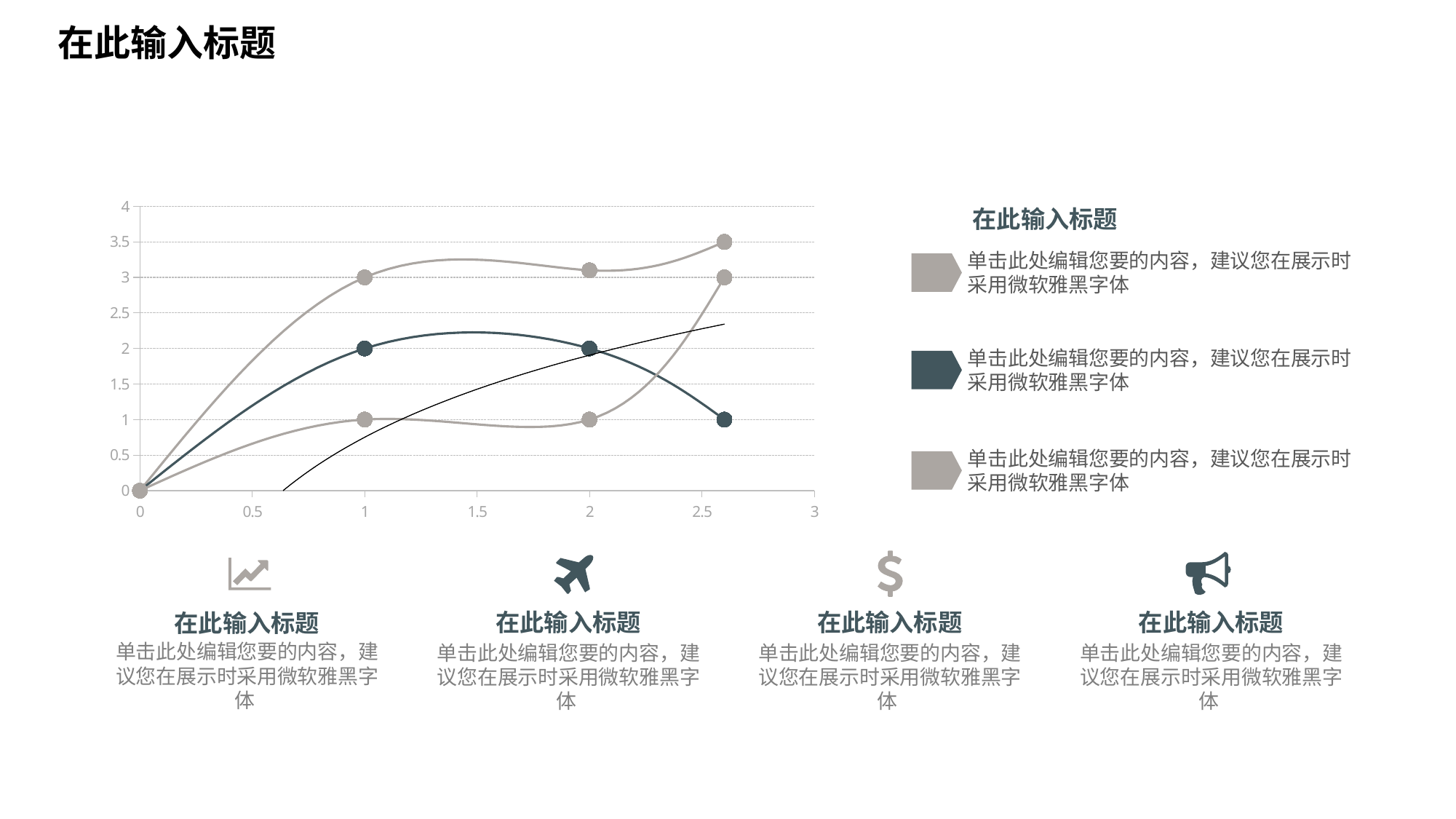
What is the y value of the lower light gray series at x = 2? 1 What is the y value of the upper light gray series at x = 1? 3 Does the dark teal series rise or fall between x = 2 and its last point? fall Is the value of the black trend line at x = 2.5 greater or less than 2? greater What is the y value of the dark teal series at x = 1? 2 What is the y value of the dark teal series at x = 2? 2 How many plotted data points does the dark teal series have? 4 What is the highest y value reached by any point on the chart? 3.5 At x = 1, which is larger: the dark teal series or the lower light gray series? the dark teal series What kind of chart is shown on the slide? scatter chart with smooth lines What is the maximum value shown on the y axis? 4 At x = 1, what is the difference between the upper light gray series and the dark teal series? 1